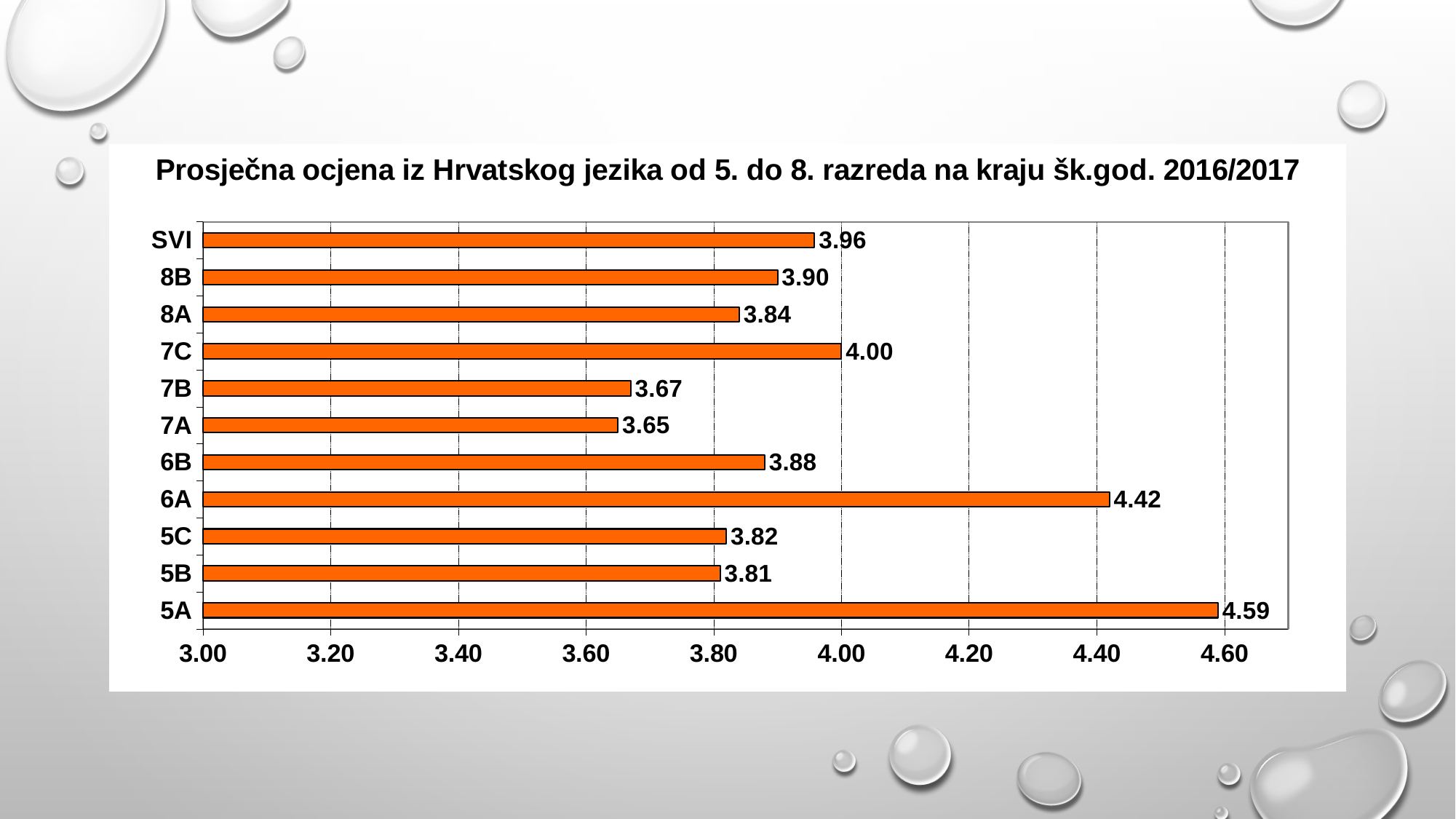
What is the difference between the values for 6A and 6B? 0.54 Which class has the highest average grade? 5A What is the average grade for class 7C? 4.00 Which class has the lowest average grade? 7A What is the title of the chart? Prosječna ocjena iz Hrvatskog jezika od 5. do 8. razreda na kraju šk.god. 2016/2017 Which has a higher average grade, 8B or 8A? 8B What is the difference between the values for 5A and 7A? 0.94 What is the average grade for class 5A? 4.59 What is the value shown for SVI? 3.96 What kind of chart is shown on the slide? Bar chart Is the value for 6A greater or less than 4.20? greater How many categories are shown on the chart? 11